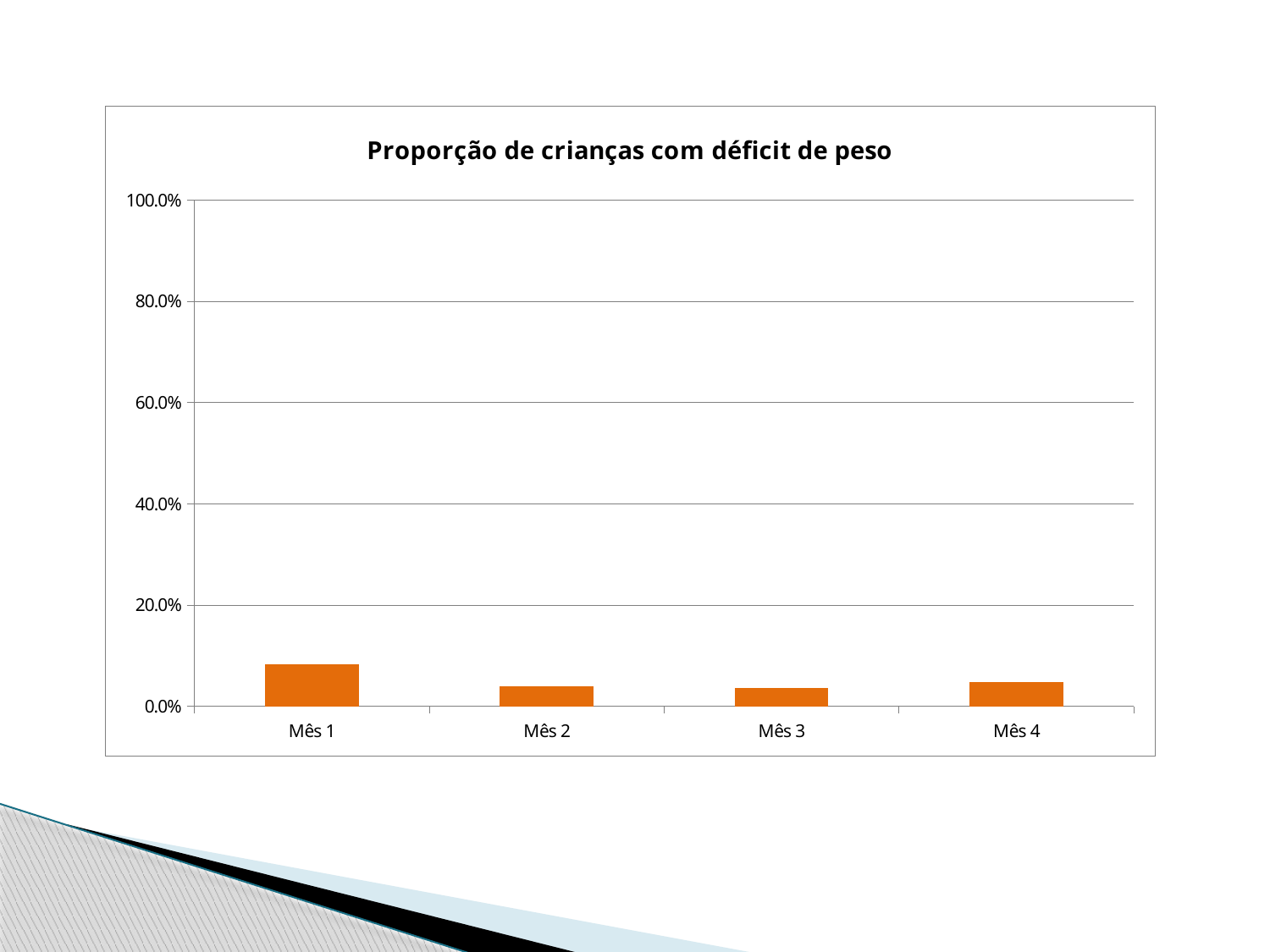
What is the title of the chart? Proporção de crianças com déficit de peso How many categories (months) are shown on the x axis? 4 What is the maximum value shown on the y axis? 100.0% Is the value for Mês 4 greater or less than 40.0%? less Is the value for Mês 1 greater or less than 20.0%? less What type of chart is shown on the slide? bar chart Which is larger, the value for Mês 1 or the value for Mês 4? Mês 1 Does the value rise or fall from Mês 3 to Mês 4? rise Which is larger, the value for Mês 1 or the value for Mês 3? Mês 1 Does the value rise or fall from Mês 1 to Mês 2? fall Is the value for Mês 3 greater or less than 20.0%? less Which month has the highest proportion of children with weight deficit? Mês 1